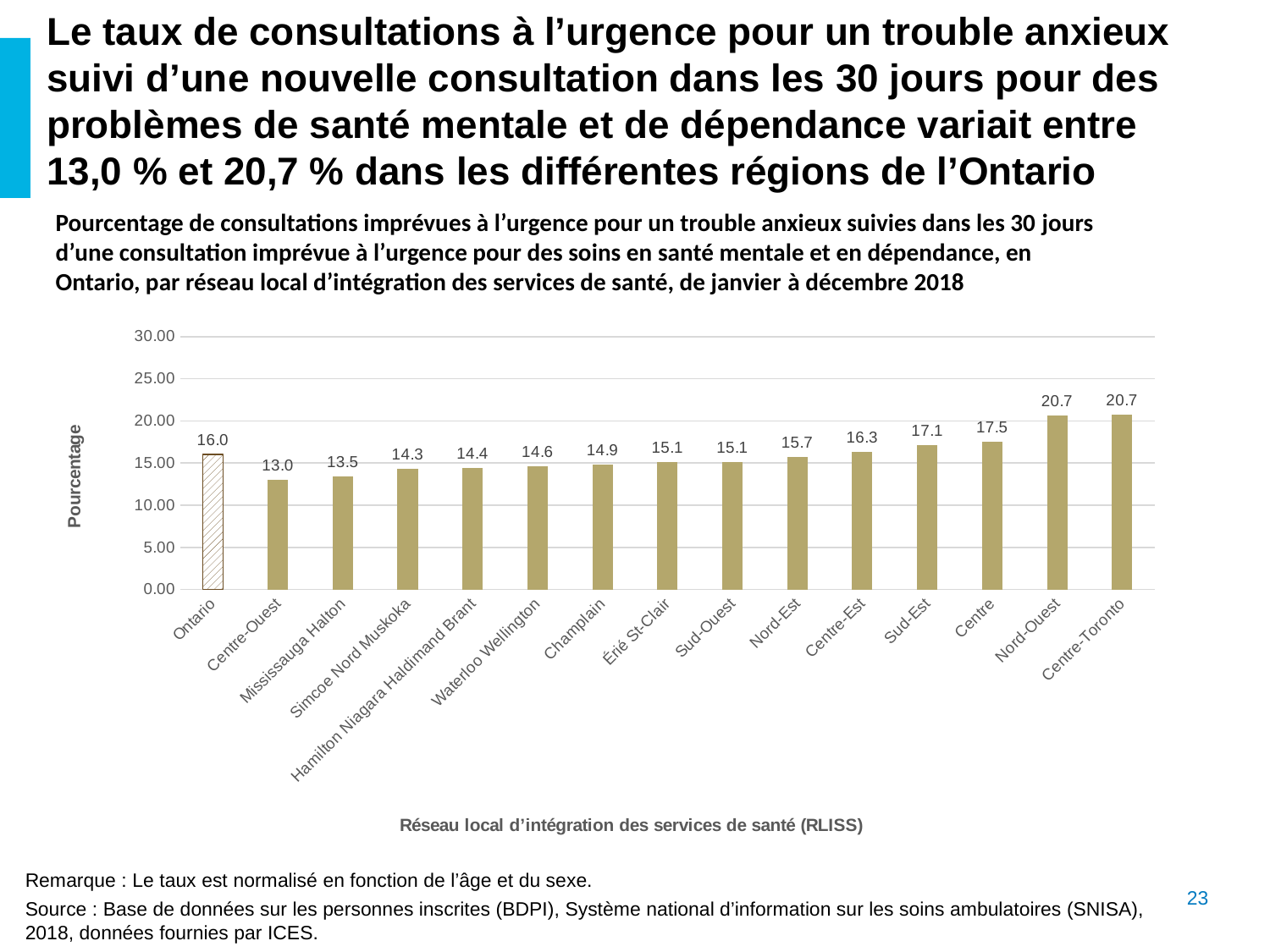
What is the value for Centre-Est? 16.3 What is the difference between the values for Centre-Toronto and Centre-Ouest? 7.7 What kind of chart is shown on the slide? Bar chart What is the difference between the values for Centre and Sud-Est? 0.4 Which category has the lowest value? Centre-Ouest How many categories are shown on the x axis? 15 What is the label of the y axis? Pourcentage Is the value for Centre-Toronto greater or less than 20.00? greater What is the value for Ontario? 16.0 What is the value for Nord-Ouest? 20.7 What is the value for Hamilton Niagara Haldimand Brant? 14.4 Which is larger, the value for Nord-Est or the value for Champlain? Nord-Est